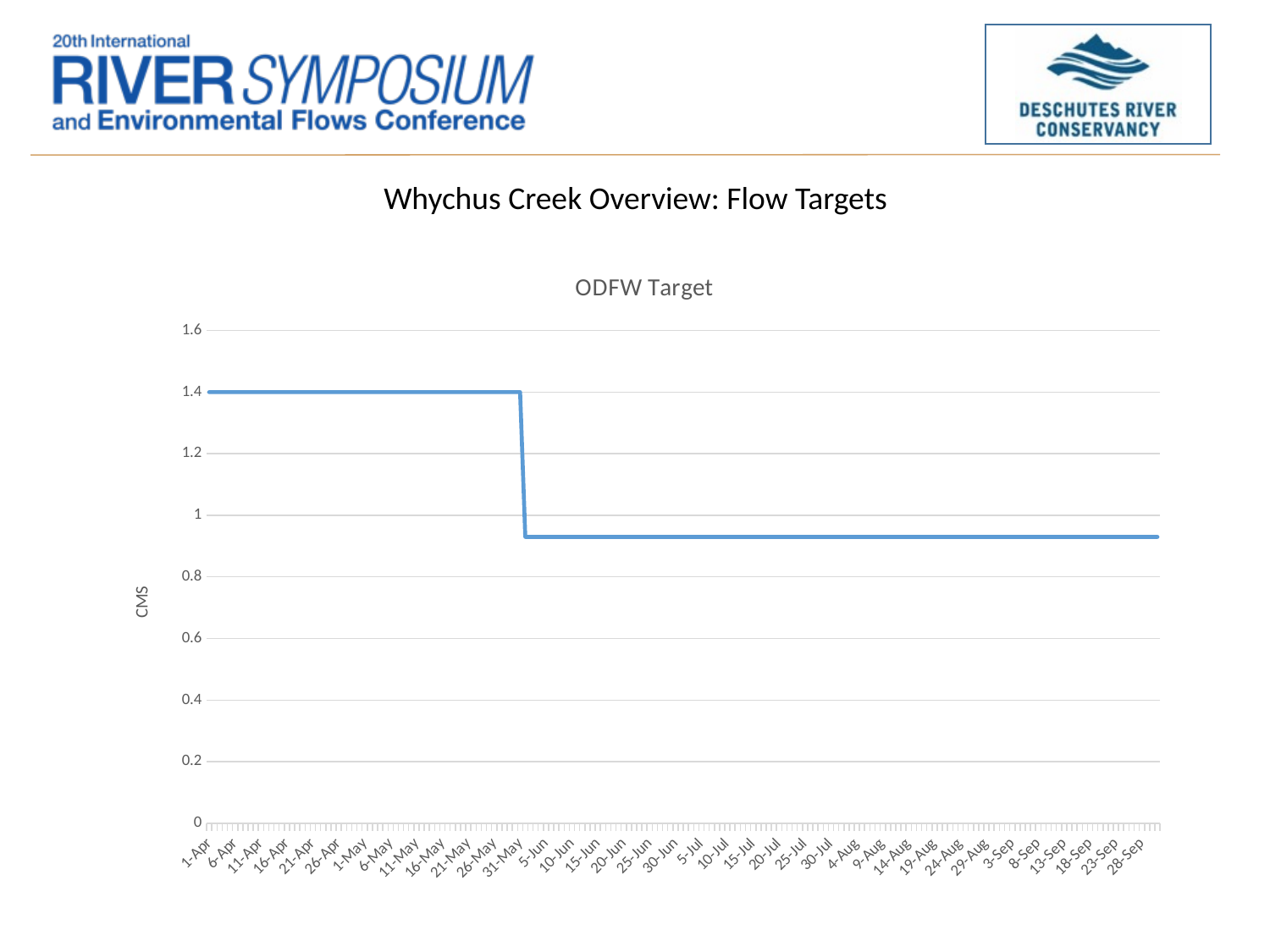
Around which x-axis label does the line drop sharply? 31-May Is the value for 28-Sep greater or less than 0.8? greater Is the value for 15-Jul greater or less than 1? less Is the value for 20-Aug greater or less than 1.4? less What is the label on the vertical axis of the chart? CMS What is the ODFW Target value on 1-Apr? 1.4 Which has the larger ODFW Target value, 1-May or 1-Jul? 1-May What is the title of the chart? ODFW Target What is the ODFW Target value on 1-May? 1.4 What kind of chart is shown on the slide? line chart Does the ODFW Target value rise or fall from April to September? fall